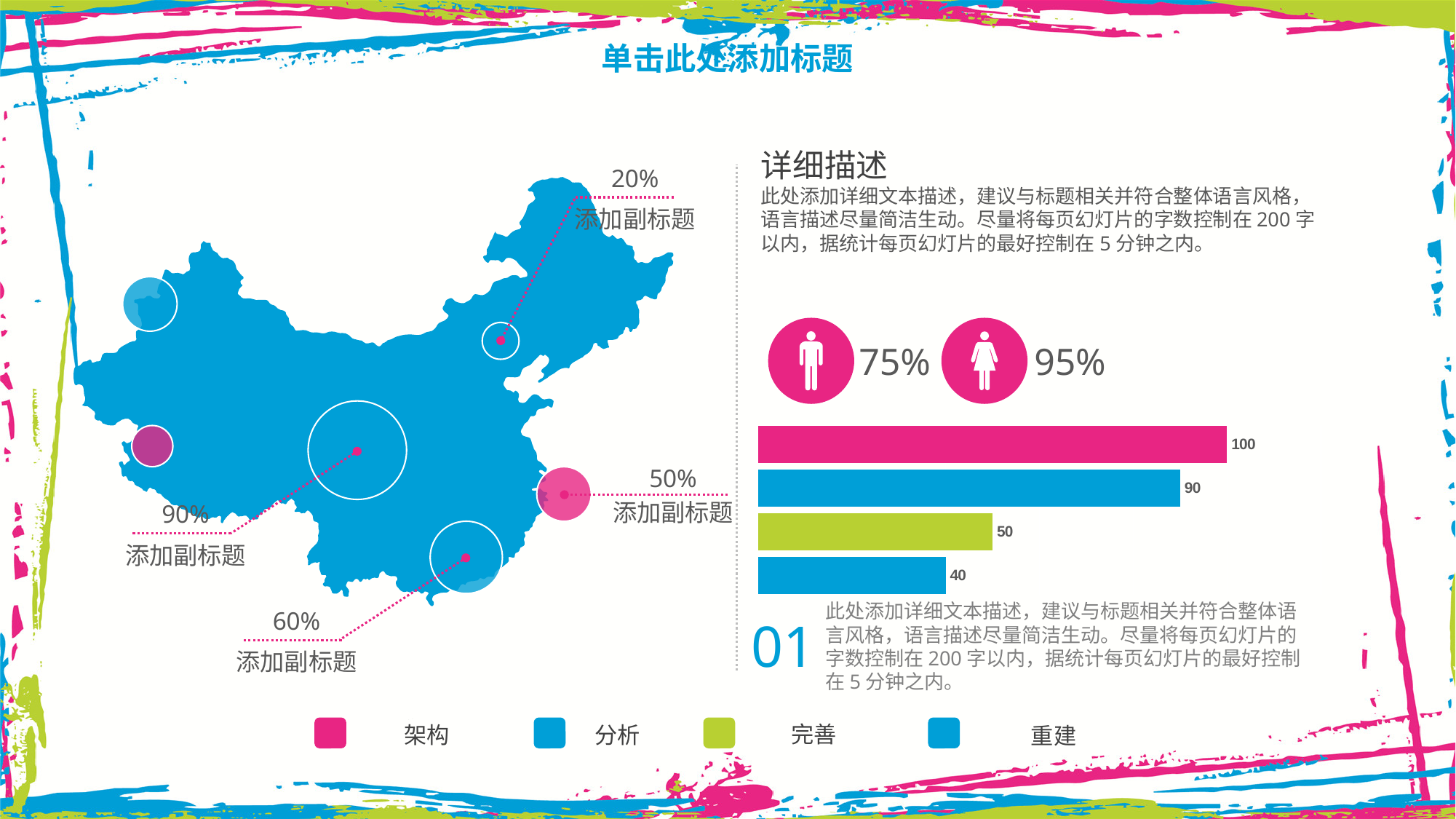
Which is larger in the bar chart: the second bar from the top or the green bar? the second bar from the top (90) What is the difference between the top bar and the second bar in the bar chart? 10 What kind of chart is shown on the right side of the slide? bar chart Do the bar values increase or decrease going from the top bar to the bottom bar? decrease Which bar in the bar chart has the lowest value? the bottom bar, 40 What is the value of the top (pink) bar in the bar chart? 100 Which bar in the bar chart has the highest value? the top (pink) bar, 100 What is the value of the green bar in the bar chart? 50 What is the value of the second bar from the top in the bar chart? 90 What is the value of the bottom bar in the bar chart? 40 What is the difference between the green bar and the bottom bar in the bar chart? 10 How many bars does the bar chart on the right contain? 4